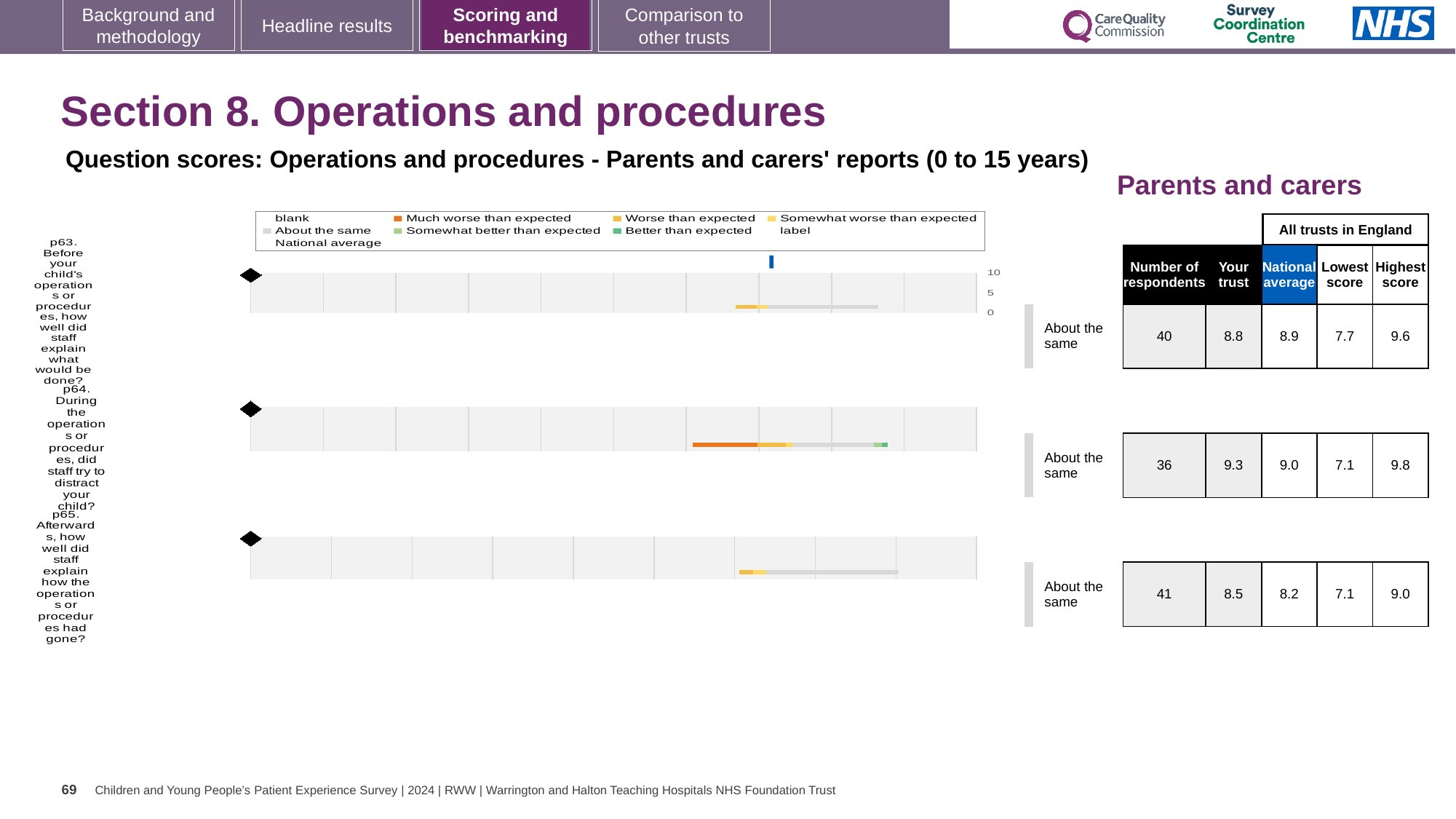
What is the maximum value shown on the chart's score axis? 10 How many question charts are shown on the slide? 3 How many respondents answered question p64? 36 What is the highest score among all trusts in England for p65 (Afterwards, how well did staff explain how the operations or procedures had gone?)? 9.0 What is the 'Your trust' score for p63 (Before your child's operations or procedures, how well did staff explain what would be done?)? 8.8 For p63, which is larger: the 'Your trust' score or the national average? National average What benchmark category is shown for p64? About the same Which question has the highest 'Your trust' score? p64 What is the national average score for p64 (During the operations or procedures, did staff try to distract your child?)? 9.0 Which question has the lowest national average score? p65 What is the difference between the 'Your trust' score and the national average for p65? 0.3 What is the lowest score among all trusts in England for p63? 7.7